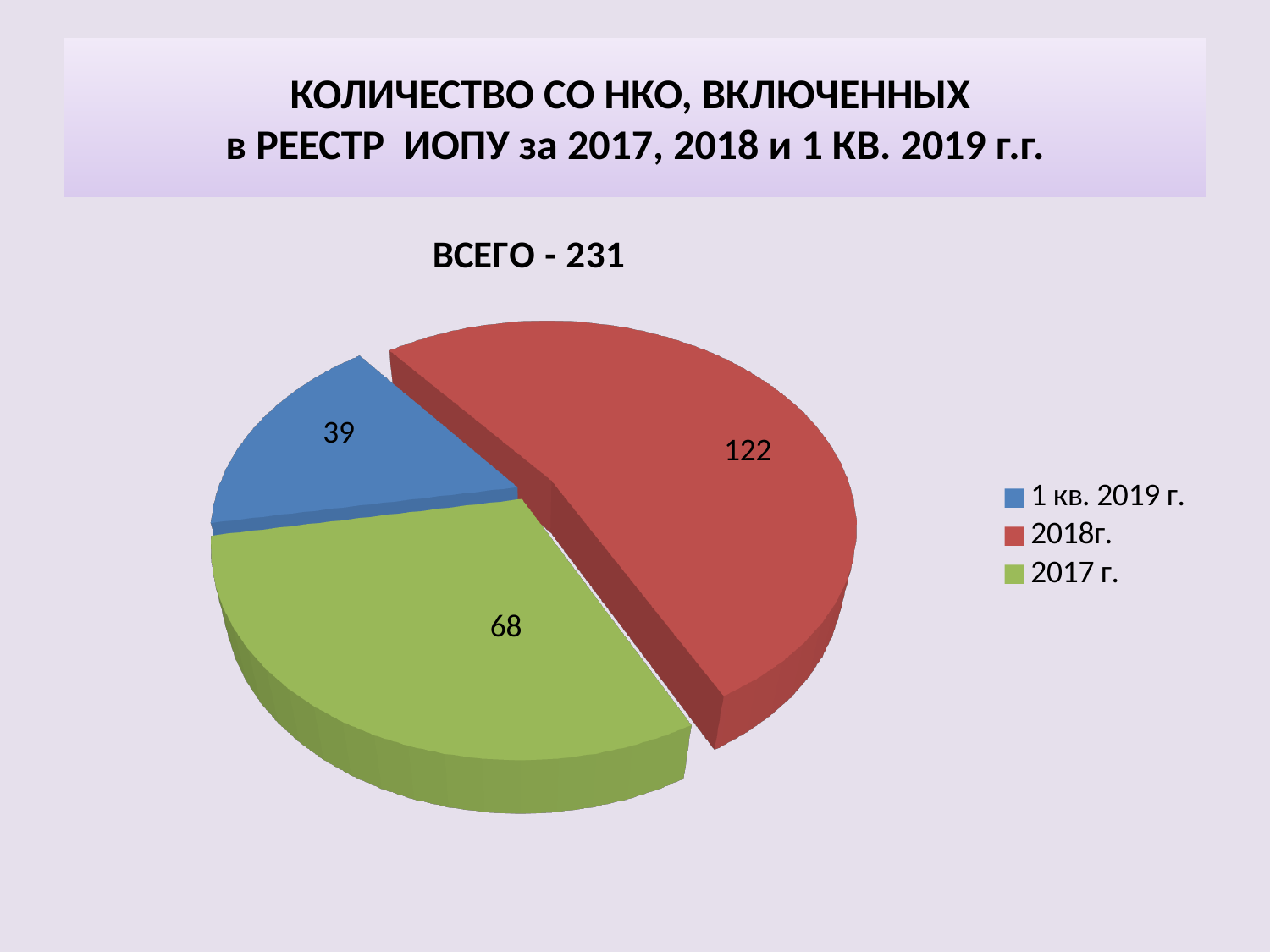
Which is larger, the value for 2017 г. or the value for 1 кв. 2019 г.? 2017 г. What kind of chart is shown on the slide? Pie chart Which category has the largest slice? 2018г. What is the value for 1 кв. 2019 г.? 39 What is the title of the chart? ВСЕГО - 231 Which category has the smallest slice? 1 кв. 2019 г. What is the difference between the values for 2018г. and 2017 г.? 54 What share of the total does the 2018г. slice represent? 52.8% What is the value for 2018г.? 122 What is the value for 2017 г.? 68 How many slices does the pie chart have? 3 What is the difference between the values for 2017 г. and 1 кв. 2019 г.? 29